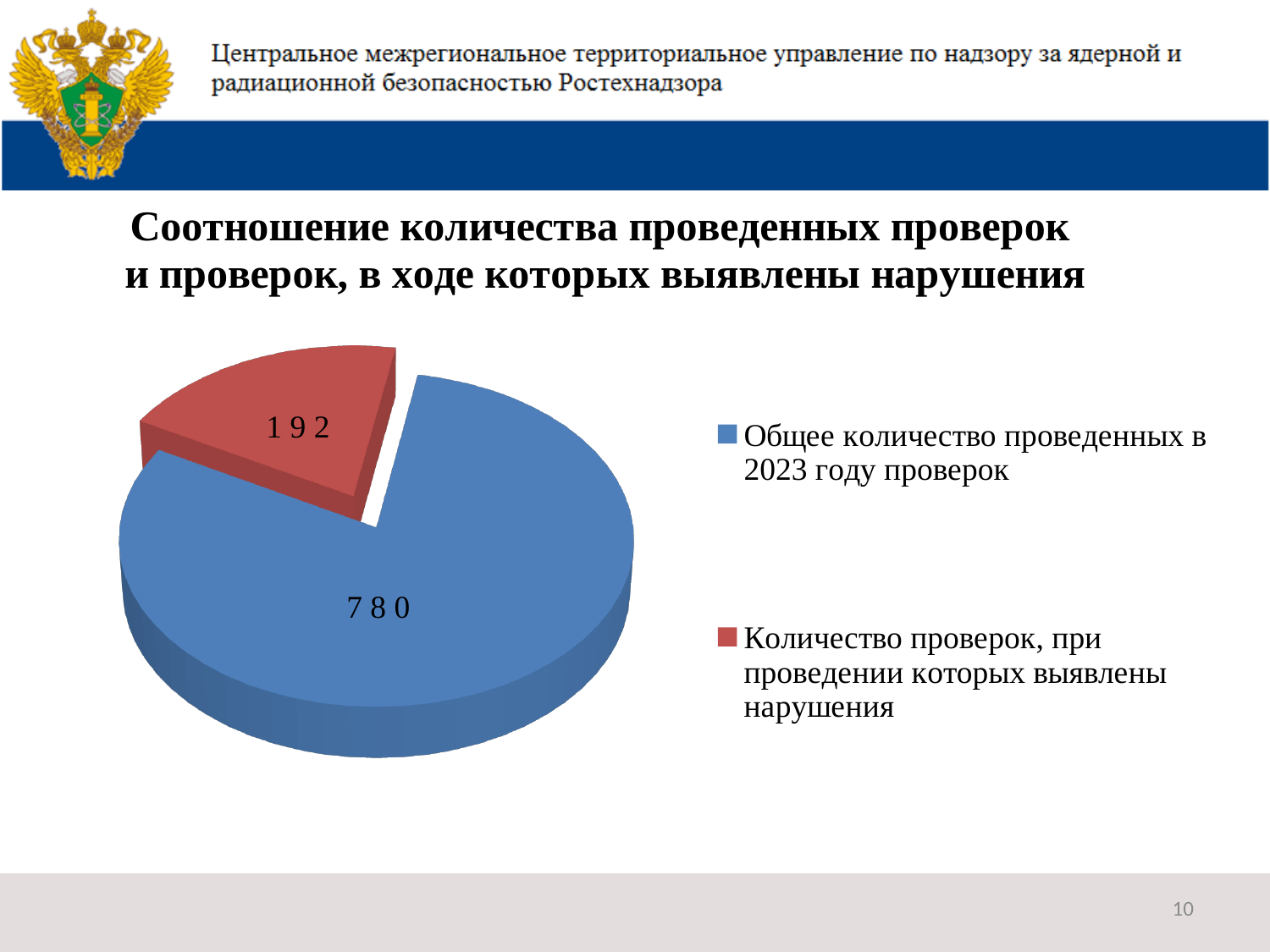
Which slice of the pie chart has the largest value? Общее количество проведенных в 2023 году проверок What value is shown for the slice 'Общее количество проведенных в 2023 году проверок'? 780 Which is larger: the value for 'Общее количество проведенных в 2023 году проверок' or the value for 'Количество проверок, при проведении которых выявлены нарушения'? Общее количество проведенных в 2023 году проверок How many entries does the chart legend list? 2 What is the difference between the value for 'Общее количество проведенных в 2023 году проверок' and the value for 'Количество проверок, при проведении которых выявлены нарушения'? 588 What value is shown for the slice 'Количество проверок, при проведении которых выявлены нарушения'? 192 What is the title of the chart on the slide? Соотношение количества проведенных проверок и проверок, в ходе которых выявлены нарушения What colour is the slice for 'Количество проверок, при проведении которых выявлены нарушения'? Red How many slices does the pie chart have? 2 Which slice of the pie chart has the smallest value? Количество проверок, при проведении которых выявлены нарушения What kind of chart is shown on the slide? Pie chart